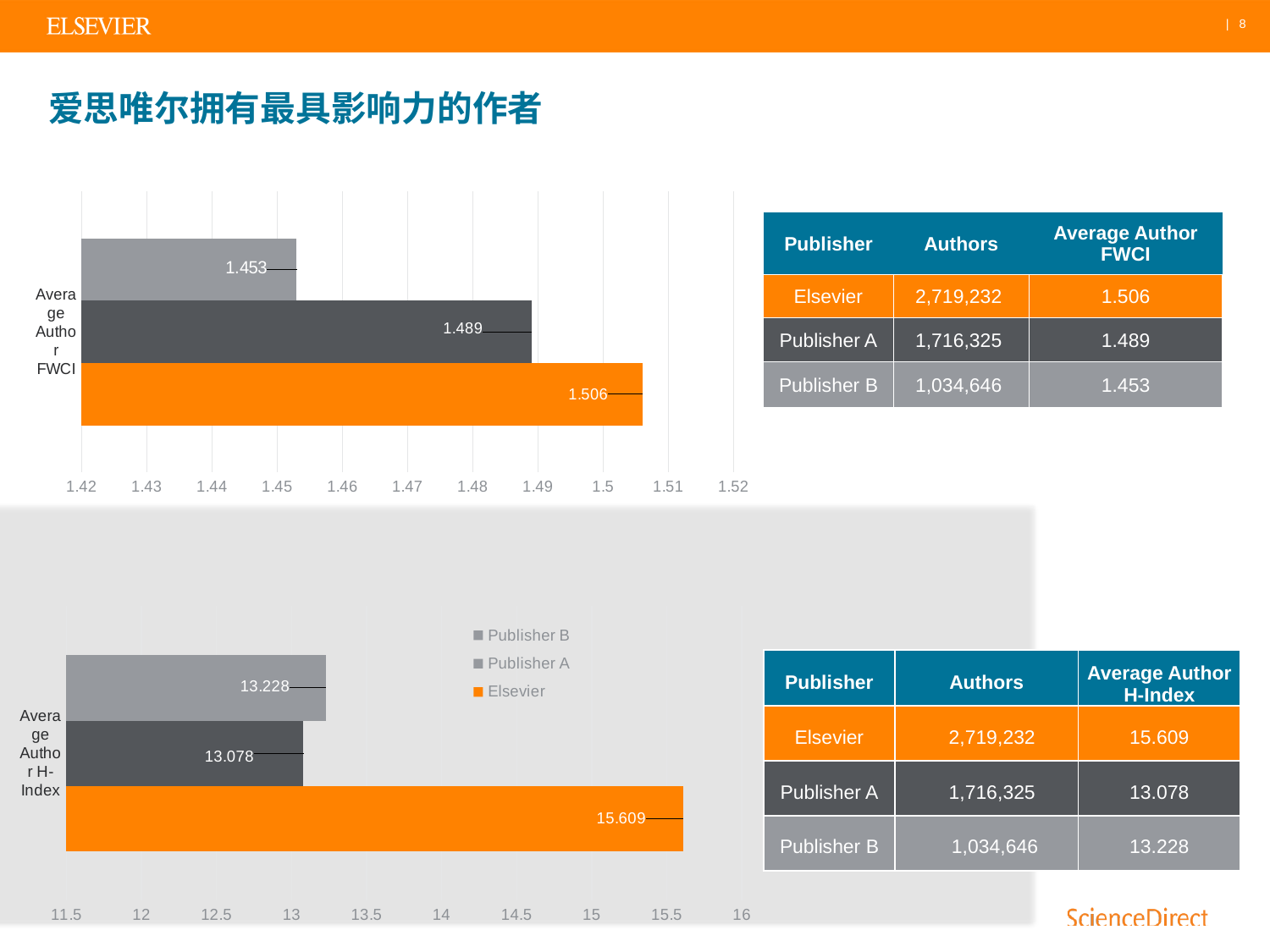
In the bottom chart (Average Author H-Index), what is the value for Elsevier? 15.609 In the top chart (Average Author FWCI), which publisher has the lowest value? Publisher B In the top chart (Average Author FWCI), what is the value for Publisher A? 1.489 In the bottom chart (Average Author H-Index), what is the value for Publisher A? 13.078 In the top chart (Average Author FWCI), what is the difference between Elsevier and Publisher B? 0.053 In the bottom chart (Average Author H-Index), which publisher has the highest value? Elsevier In the bottom chart (Average Author H-Index), which is larger, Publisher A or Publisher B? Publisher B What kind of chart is the top chart (Average Author FWCI)? Bar chart In the top chart (Average Author FWCI), what is the value for Elsevier? 1.506 In the bottom chart (Average Author H-Index), what is the difference between Elsevier and Publisher A? 2.531 How many series does the legend of the bottom chart list? 3 In the top chart (Average Author FWCI), what is the value for Publisher B? 1.453